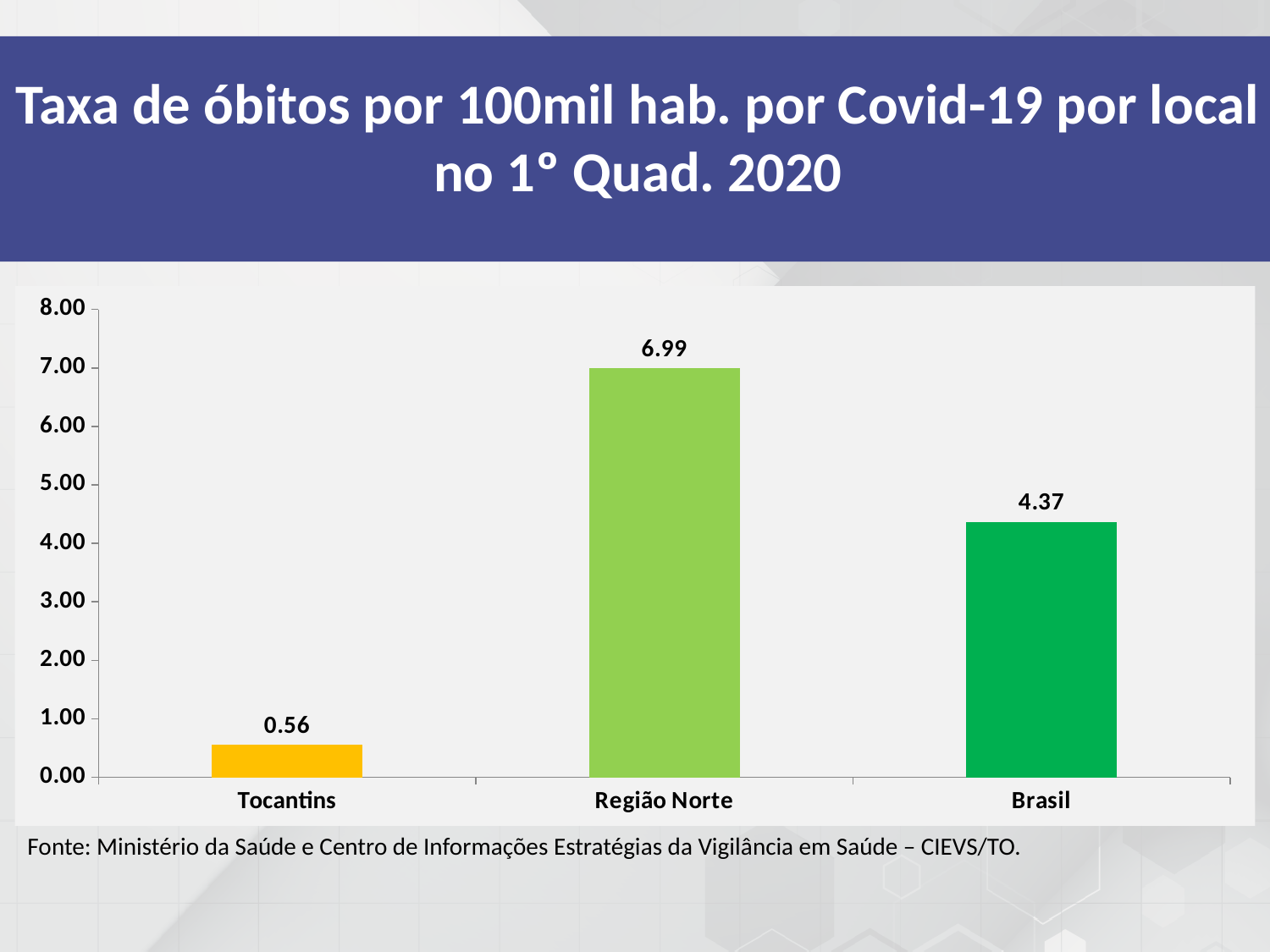
Which is larger, the value for Tocantins or the value for Brasil? Brasil What is the value shown for Região Norte? 6.99 Which location has the highest death rate? Região Norte What is the difference between the values for Brasil and Tocantins? 3.81 Is the value for Região Norte greater or less than 6.00? greater What kind of chart is shown on the slide? bar chart Which location has the lowest death rate? Tocantins What is the value shown for Brasil? 4.37 What is the death rate per 100 thousand inhabitants for Tocantins? 0.56 What is the difference between the values for Região Norte and Brasil? 2.62 What colour is the bar for Tocantins? yellow How many locations are shown on the chart? 3